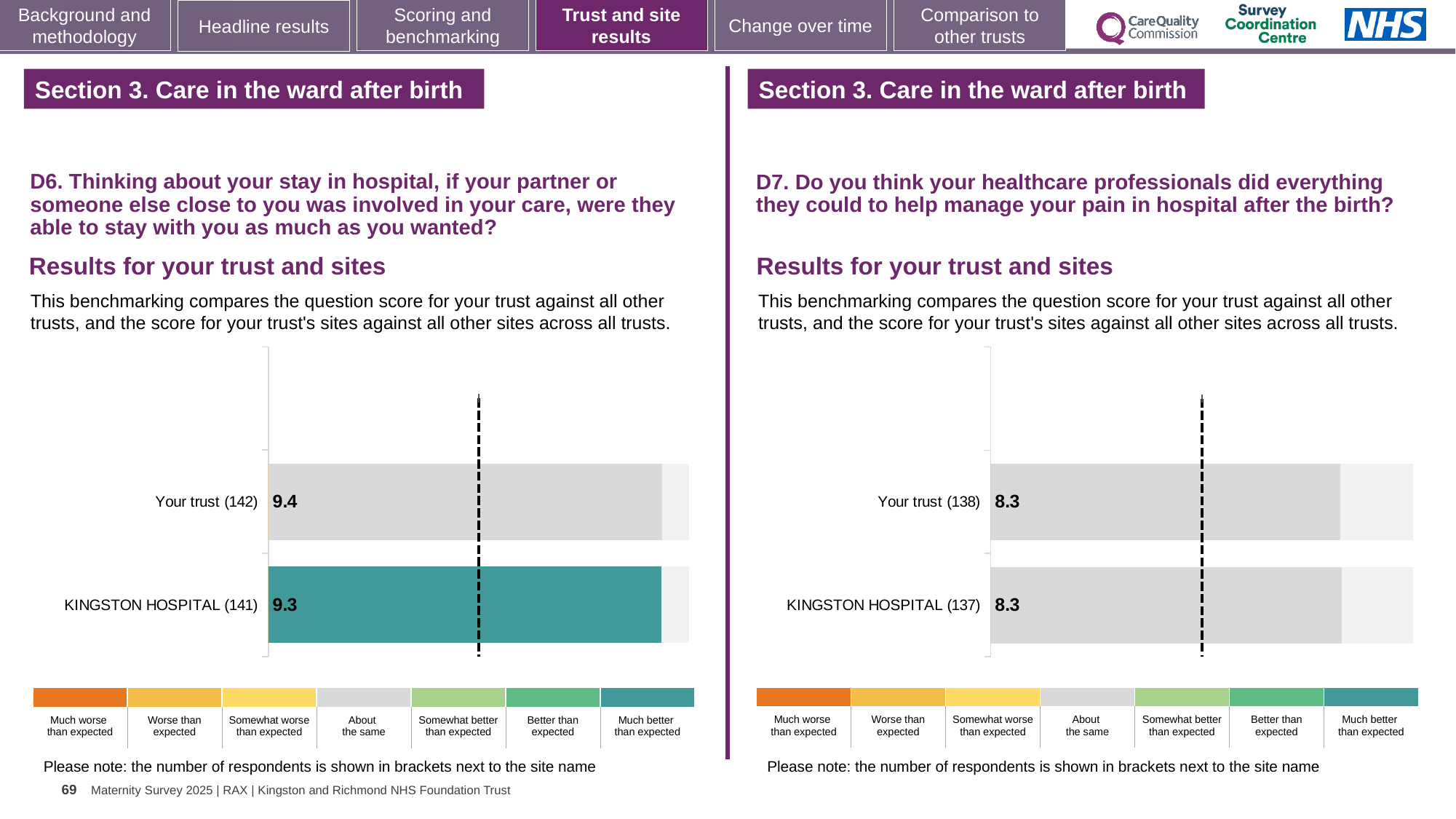
On the D6 chart (left), what is the difference between the score for Your trust and the score for KINGSTON HOSPITAL? 0.1 What type of chart is used on the D7 chart (right)? Bar chart On the D7 chart (right), how many respondents are shown in brackets for Your trust? 138 On the D6 chart (left), which has the higher score, Your trust or KINGSTON HOSPITAL? Your trust On the D6 chart (left), what is the score for Your trust? 9.4 On the D7 chart (right), what is the difference between the score for Your trust and the score for KINGSTON HOSPITAL? 0 On the D7 chart (right), what is the score for KINGSTON HOSPITAL? 8.3 On the D6 chart (left), how many respondents are shown in brackets for KINGSTON HOSPITAL? 141 On the D6 chart (left), what is the score for KINGSTON HOSPITAL? 9.3 How many bars are plotted on the D6 chart (left)? 2 On the D6 chart (left), which benchmark category does the colour of the KINGSTON HOSPITAL bar correspond to in the legend? Much better than expected On the D7 chart (right), what is the score for Your trust? 8.3